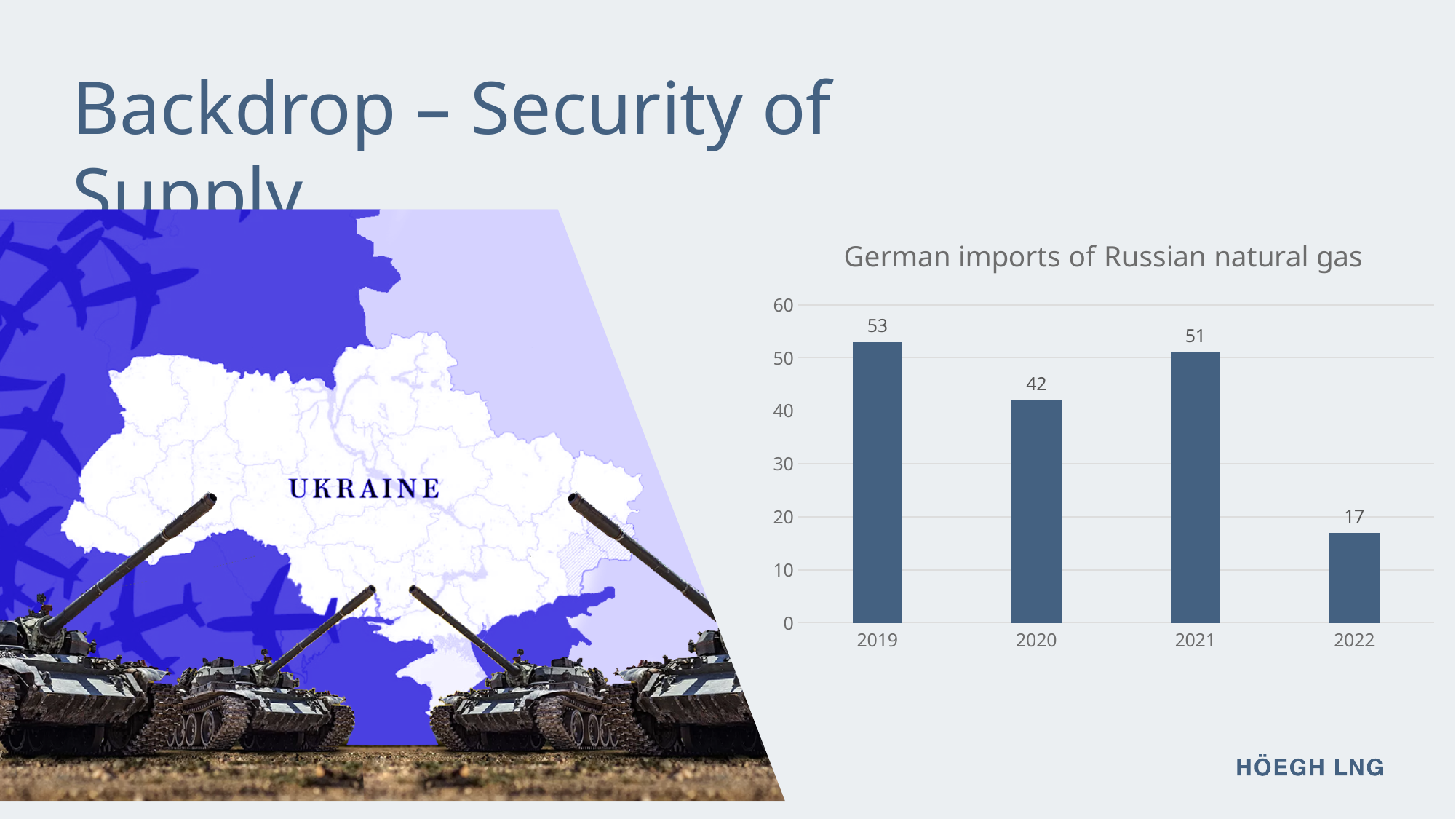
What is the value for 2022 in the German imports of Russian natural gas chart? 17 What is the difference between the values for 2021 and 2022? 34 What is the value for 2020 in the German imports of Russian natural gas chart? 42 Is the value for 2022 greater or less than 20? less Which year has the highest value in the chart? 2019 Which year has the lowest value in the chart? 2022 What is the title of the chart? German imports of Russian natural gas What kind of chart is shown on the slide? bar chart What is the value for 2019 in the German imports of Russian natural gas chart? 53 What is the value for 2021 in the German imports of Russian natural gas chart? 51 Which is larger, the value for 2020 or the value for 2021? 2021 How many years are shown on the x axis of the chart? 4